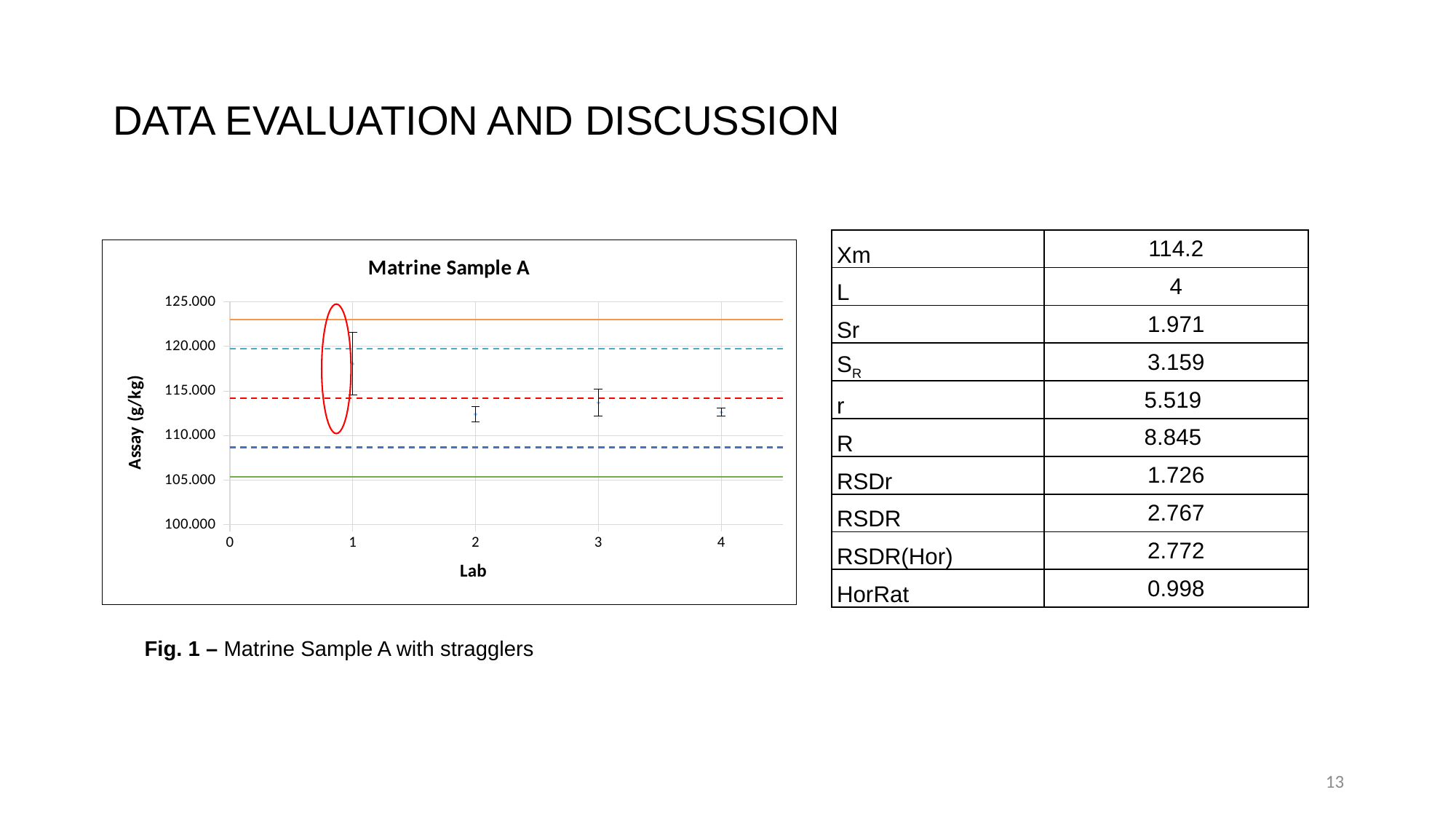
Which lab has the widest error bar on the chart? Lab 1 What kind of chart is shown on the slide? Scatter chart with error bars What is the title of the chart? Matrine Sample A What is the label of the y axis of the chart? Assay (g/kg) Is the value for Lab 1 greater or less than 110.000? greater Is the solid orange horizontal line on the chart above or below 120.000? above How many labs are plotted on the chart? 4 Which lab shows the highest assay values on the chart? Lab 1 Is the value for Lab 3 greater or less than 110.000? greater